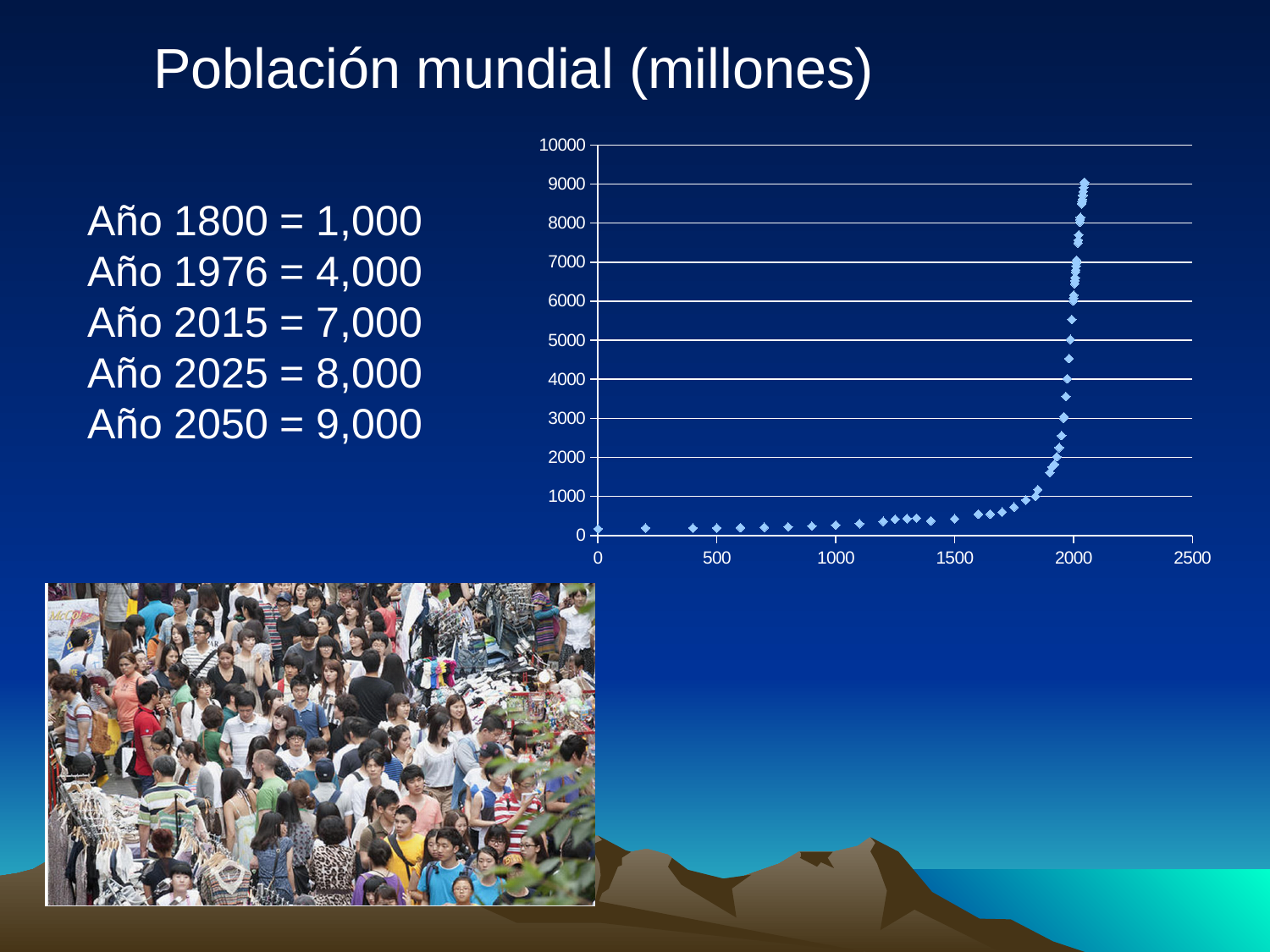
Which is larger: the plotted population value near year 2000 or the value at year 1500? near year 2000 Is the plotted population value at year 1000 greater or less than 1000? less Is the plotted population value at year 500 greater or less than 1000? less What is the maximum value shown on the vertical axis of the chart? 10000 Is the highest plotted population value greater or less than 10000? less Do the plotted population values rise or fall as the year increases along the x axis? rise In which part of the x-axis range do the plotted points rise most steeply? near 2000 What kind of chart is shown on the slide? scatter chart What is the maximum value shown on the horizontal axis of the chart? 2500